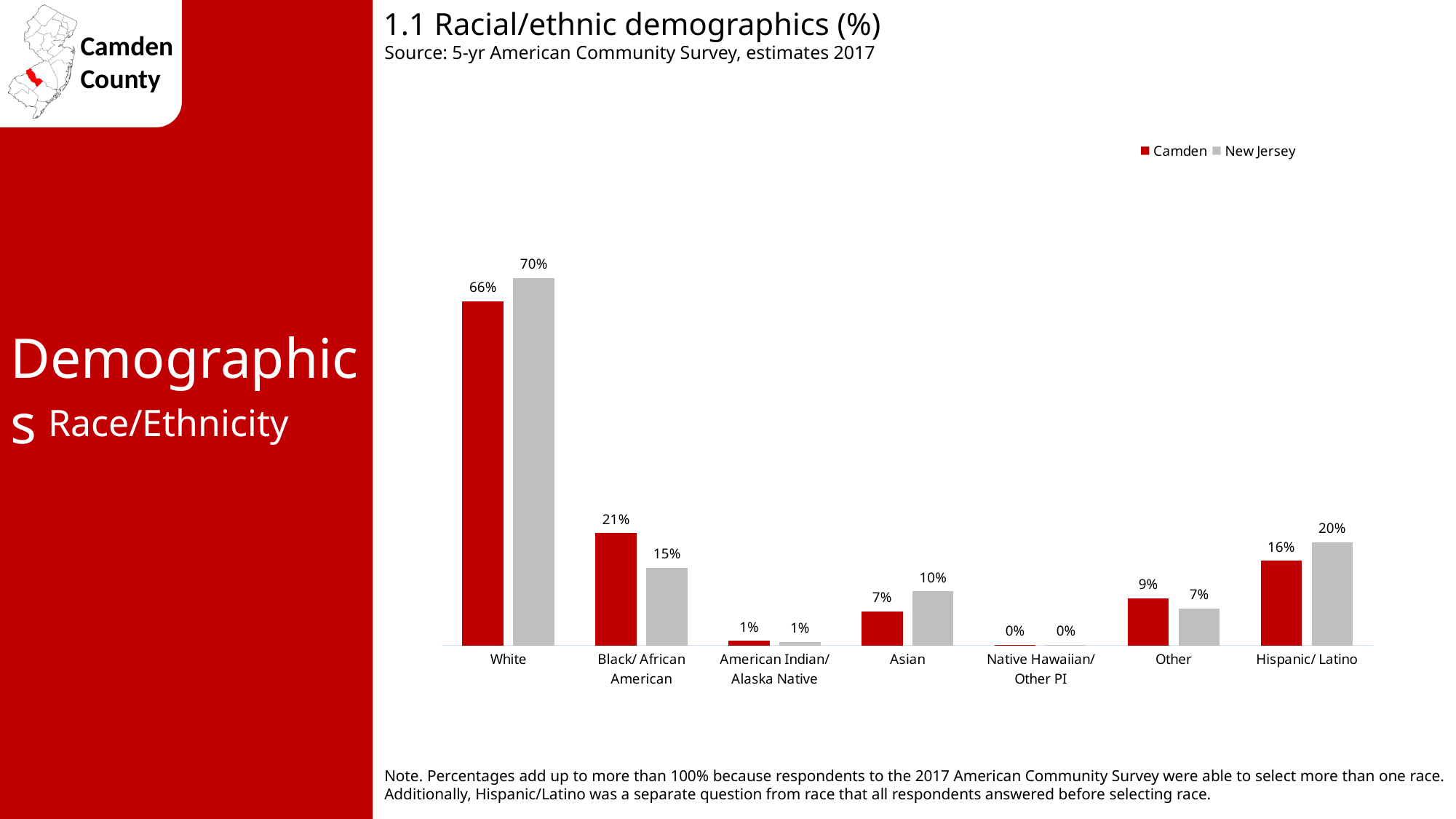
What is the Camden value for White? 66% What is the Camden value for Black/ African American? 21% Which is larger for Other, the Camden value or the New Jersey value? Camden How many series does the legend list? 2 What is the difference between the Camden and New Jersey values for Black/ African American? 6% What is the difference between the New Jersey and Camden values for White? 4% How many categories are shown on the x axis? 7 What is the New Jersey value for Hispanic/ Latino? 20% What is the New Jersey value for Asian? 10% Which category has the lowest New Jersey value? Native Hawaiian/ Other PI Which category has the highest Camden value? White What kind of chart is shown? Bar chart